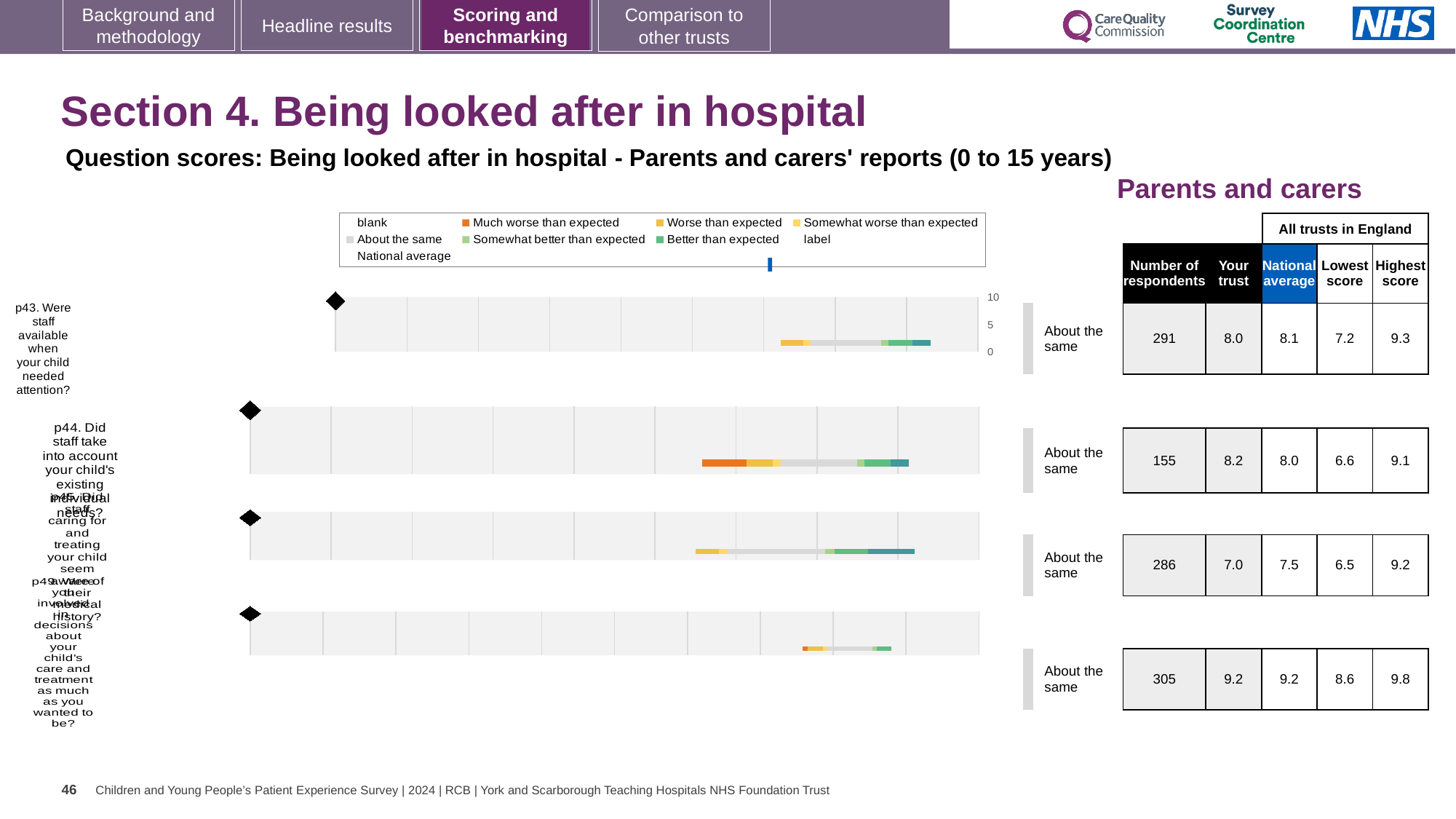
What is the 'Your trust' score for question p43? 8.0 What benchmark category is shown next to every question row? About the same Which question row has the highest 'Your trust' score? The fourth (bottom) row, p49, with 9.2 What is the lowest score among all trusts in England for the third question row? 6.5 What is the difference between the highest score and the lowest score for question p43? 2.1 For the third question row, which is larger: the 'Your trust' score or the national average? National average (7.5) How many respondents are shown for question p43 (Were staff available when your child needed attention?)? 291 How many question rows (charts) are shown on the slide? 4 Which question row has the fewest respondents? The second row, p44, with 155 What is the national average score for question p43? 8.1 What kind of chart is used for each question row? Bar chart What is the highest score among all trusts in England for the fourth (bottom) question row? 9.8